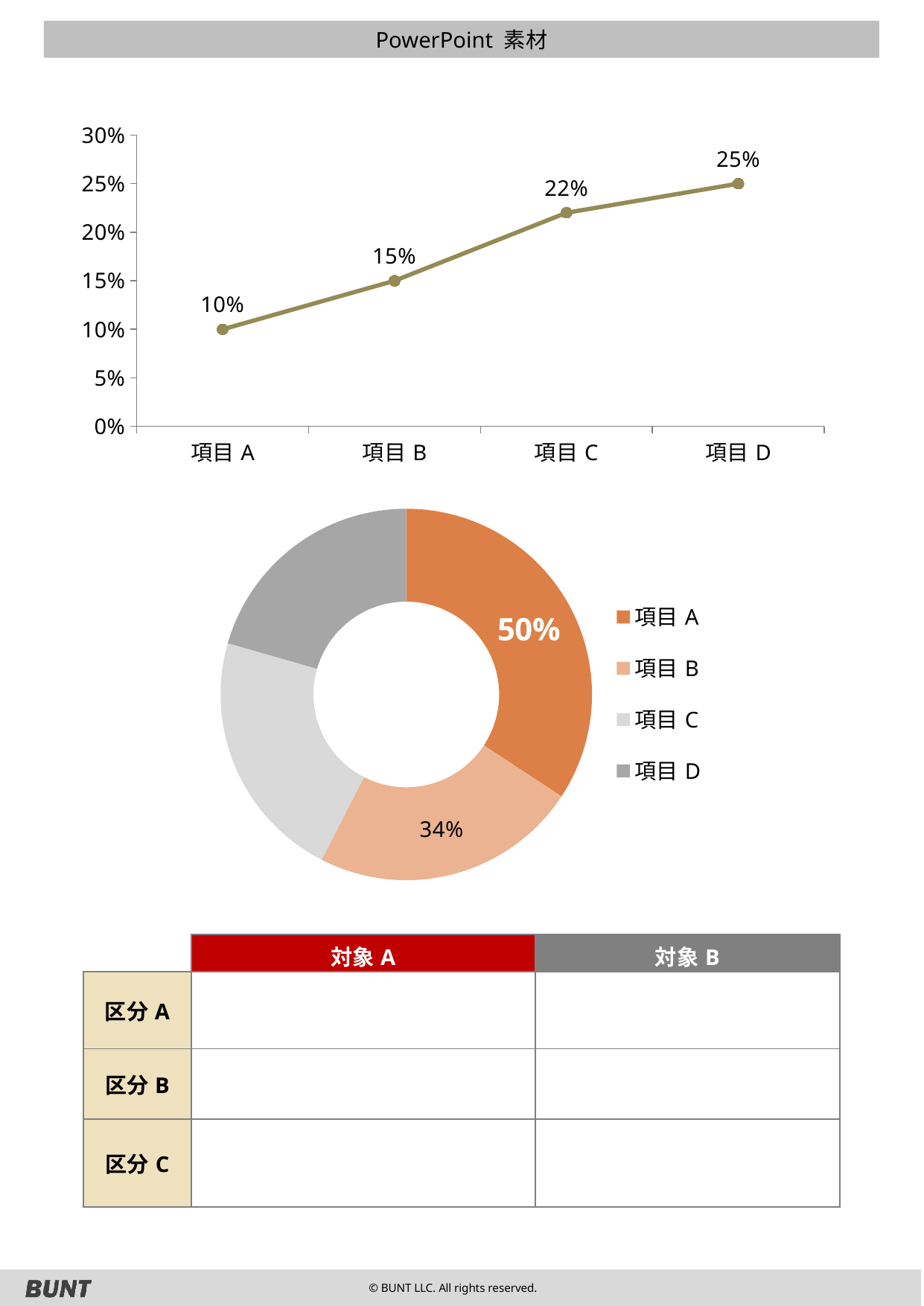
What kind of chart is the chart at the top of the slide? line chart In the line chart at the top, how many categories are plotted? 4 In the line chart at the top, do the values rise or fall from 項目 A to 項目 D? rise In the line chart at the top, which is larger, the value for 項目 B or the value for 項目 C? 項目 C In the doughnut chart in the middle, how many entries does the legend list? 4 In the doughnut chart in the middle, what percentage label is shown on the 項目 A slice? 50% In the line chart at the top, what is the difference between the values for 項目 D and 項目 B? 10% In the doughnut chart in the middle, what percentage label is shown on the 項目 B slice? 34% In the line chart at the top, what is the value for 項目 C? 22% In the line chart at the top, which category has the highest value? 項目 D In the line chart at the top, which category has the lowest value? 項目 A In the line chart at the top, what is the value for 項目 A? 10%